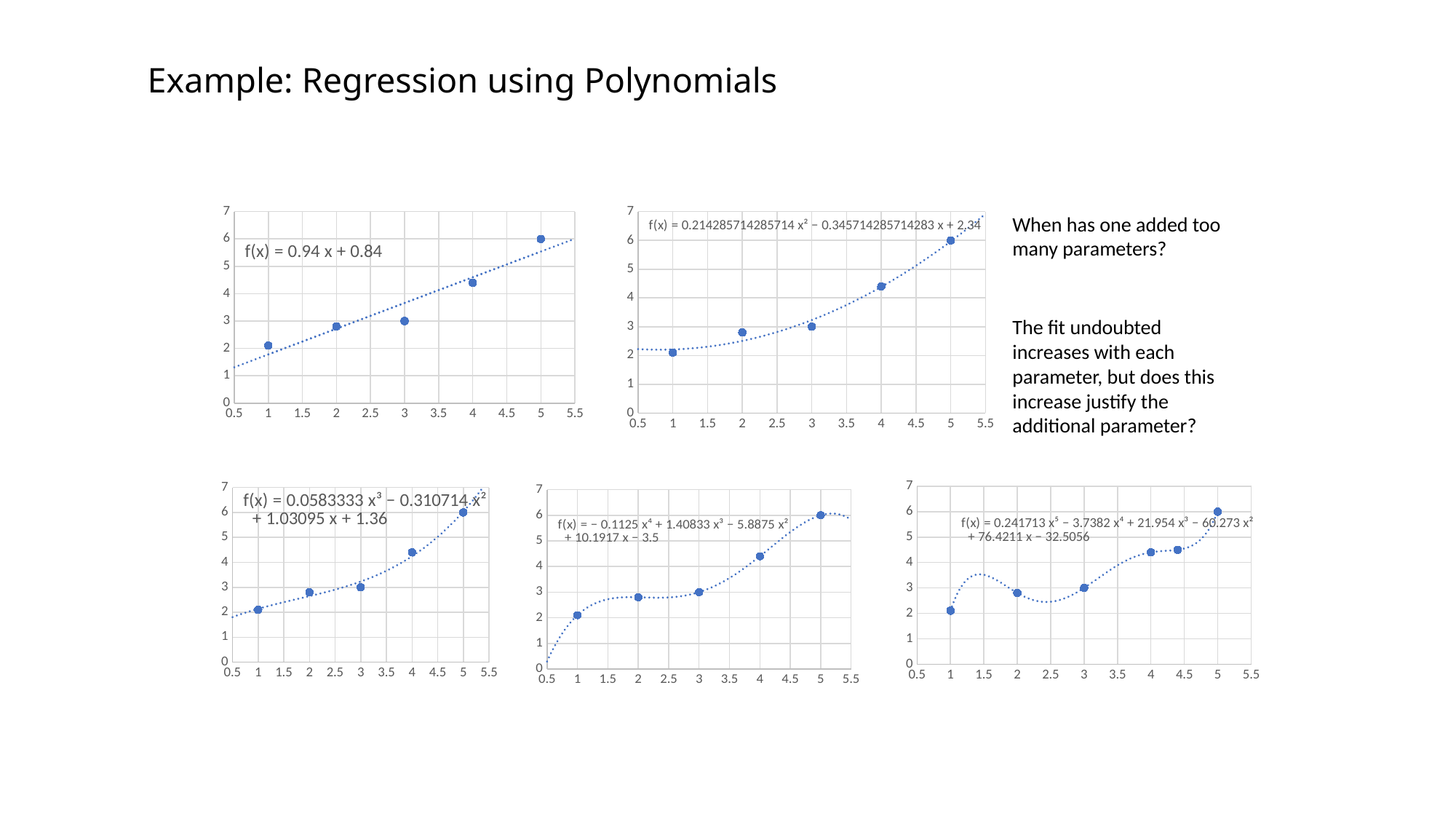
In the bottom-right chart, how many data points are plotted? 6 In the bottom-left chart, which x value has the highest plotted point? 5 In the top-left chart, is the value at x = 5 greater or less than 5? greater In the top-right chart, is the point at x = 5 higher or lower than the point at x = 4? higher In the bottom-left chart, which x value has the lowest plotted point? 1 What kind of chart is the top-left chart? scatter chart In the bottom-middle chart, is the value at x = 2 greater or less than 3? less In the top-right chart, is the value at x = 4 greater or less than 4? greater In the top-left chart, do the plotted values rise or fall as x increases? rise In the top-left chart, how many data points are plotted? 5 What is the fitted equation shown on the top-left chart? f(x) = 0.94 x + 0.84